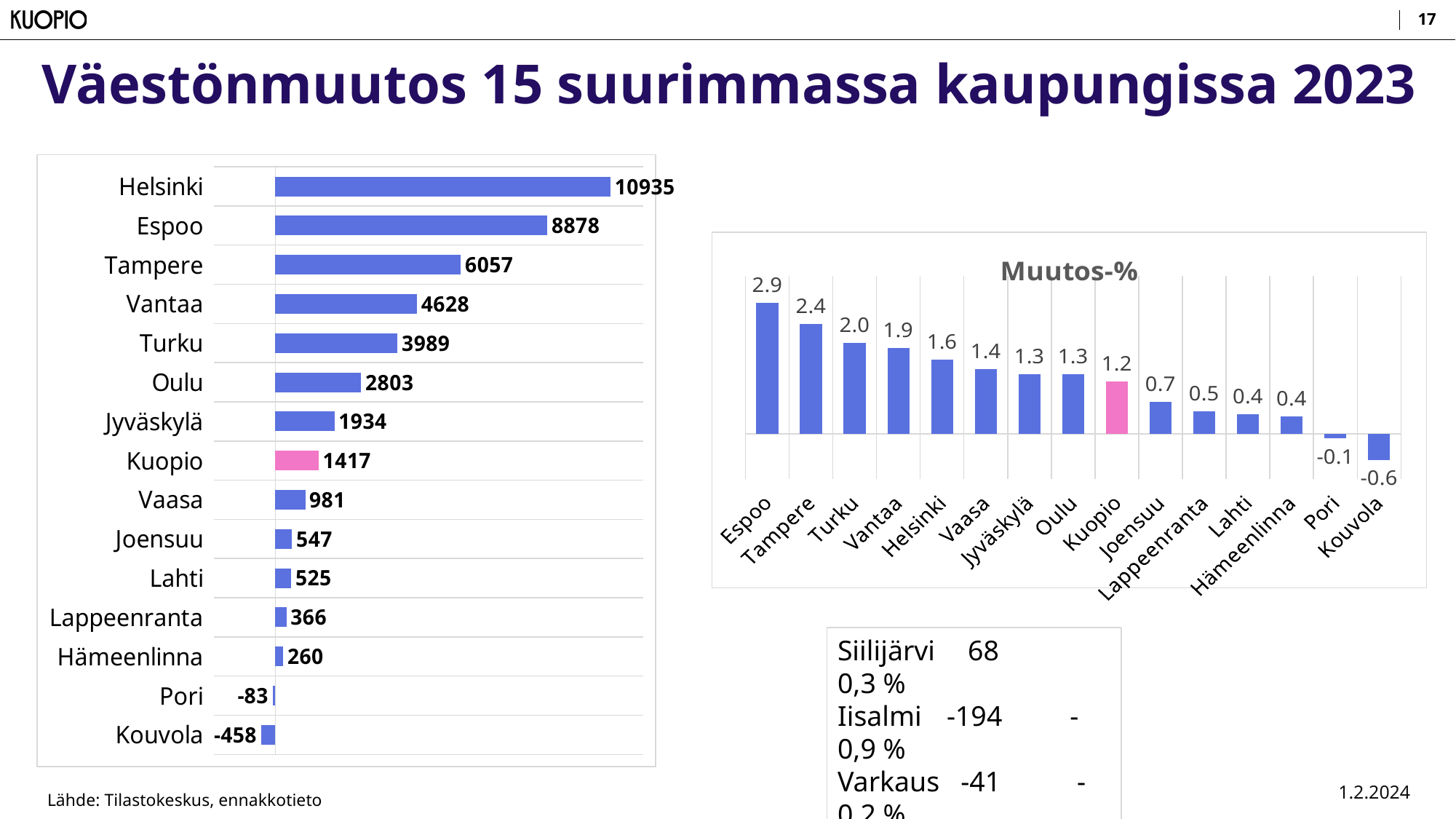
In the left chart, which city has the lowest value? Kouvola In the Muutos-% chart, which city has the highest value? Espoo What kind of chart is the left chart? bar chart In the Muutos-% chart, do the values rise or fall from left to right along the x axis? fall In the Muutos-% chart, which city has the lowest value? Kouvola In the left chart, which is larger, the value for Oulu or the value for Jyväskylä? Oulu In the left chart, what is the difference between the values for Helsinki and Espoo? 2057 In the left chart, what is the value for Kuopio? 1417 In the Muutos-% chart, what is the value for Kuopio? 1.2 In the Muutos-% chart, what is the difference between the values for Espoo and Tampere? 0.5 In the left chart, how many cities are shown? 15 In the left chart, which city has the highest value? Helsinki